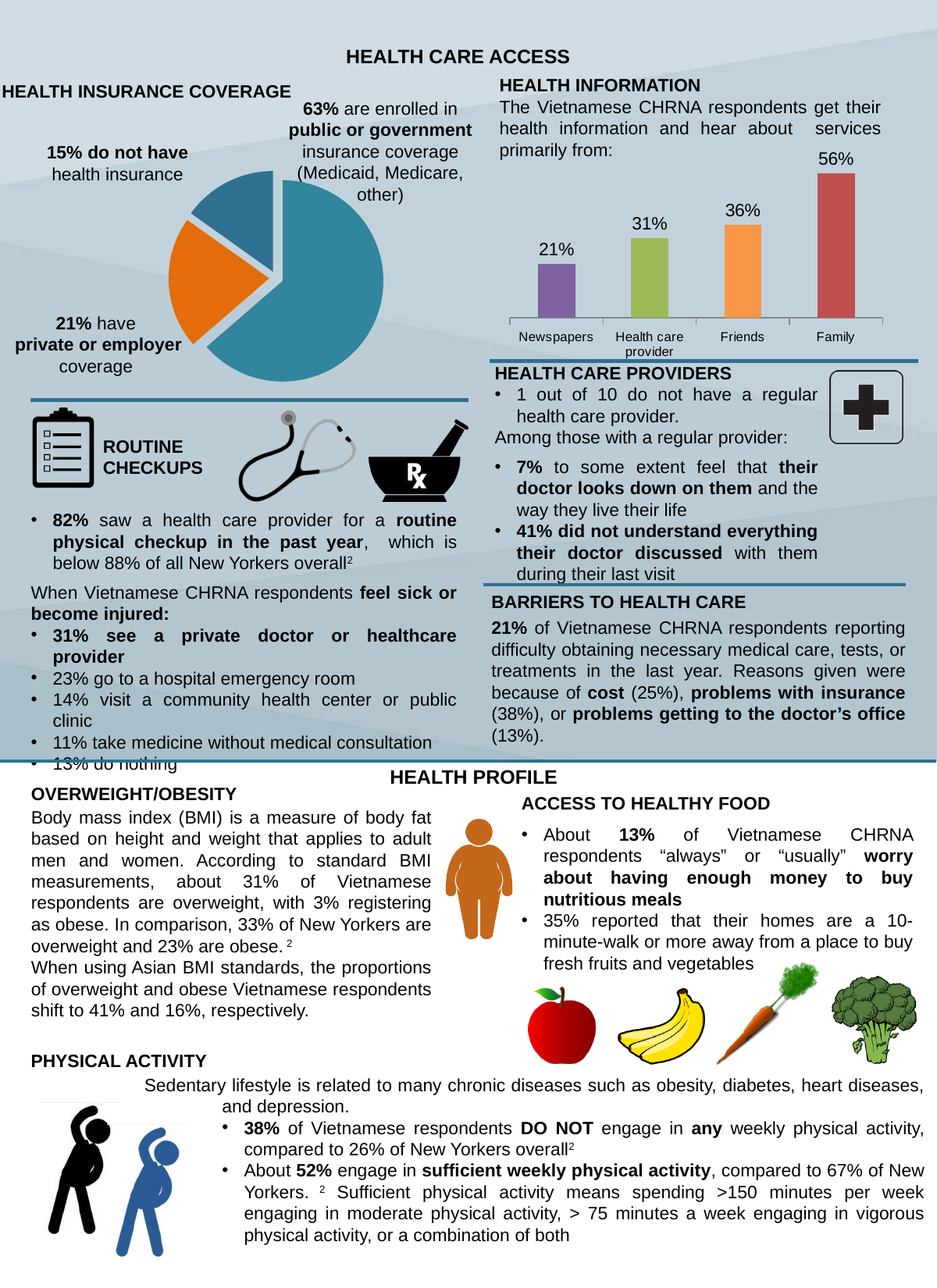
In the health information bar chart, which is larger, the value for Friends or the value for Health care provider? Friends In the health information bar chart, which source has the lowest value? Newspapers In the health insurance coverage pie chart, what share of respondents are enrolled in public or government insurance coverage? 63% What kind of chart is used to show where respondents get their health information? Bar chart In the health information bar chart, what is the difference between the values for Family and Friends? 20% How many categories are shown in the health information bar chart? 4 In the health information bar chart, do the values rise or fall from Newspapers to Family along the x axis? Rise In the health information bar chart, what is the value for Newspapers? 21% In the health information bar chart, what is the value for Health care provider? 31% In the health information bar chart, which source has the highest value? Family In the health information bar chart, what percentage of respondents get their health information from Family? 56% In the health insurance coverage pie chart, what share of respondents do not have health insurance? 15%